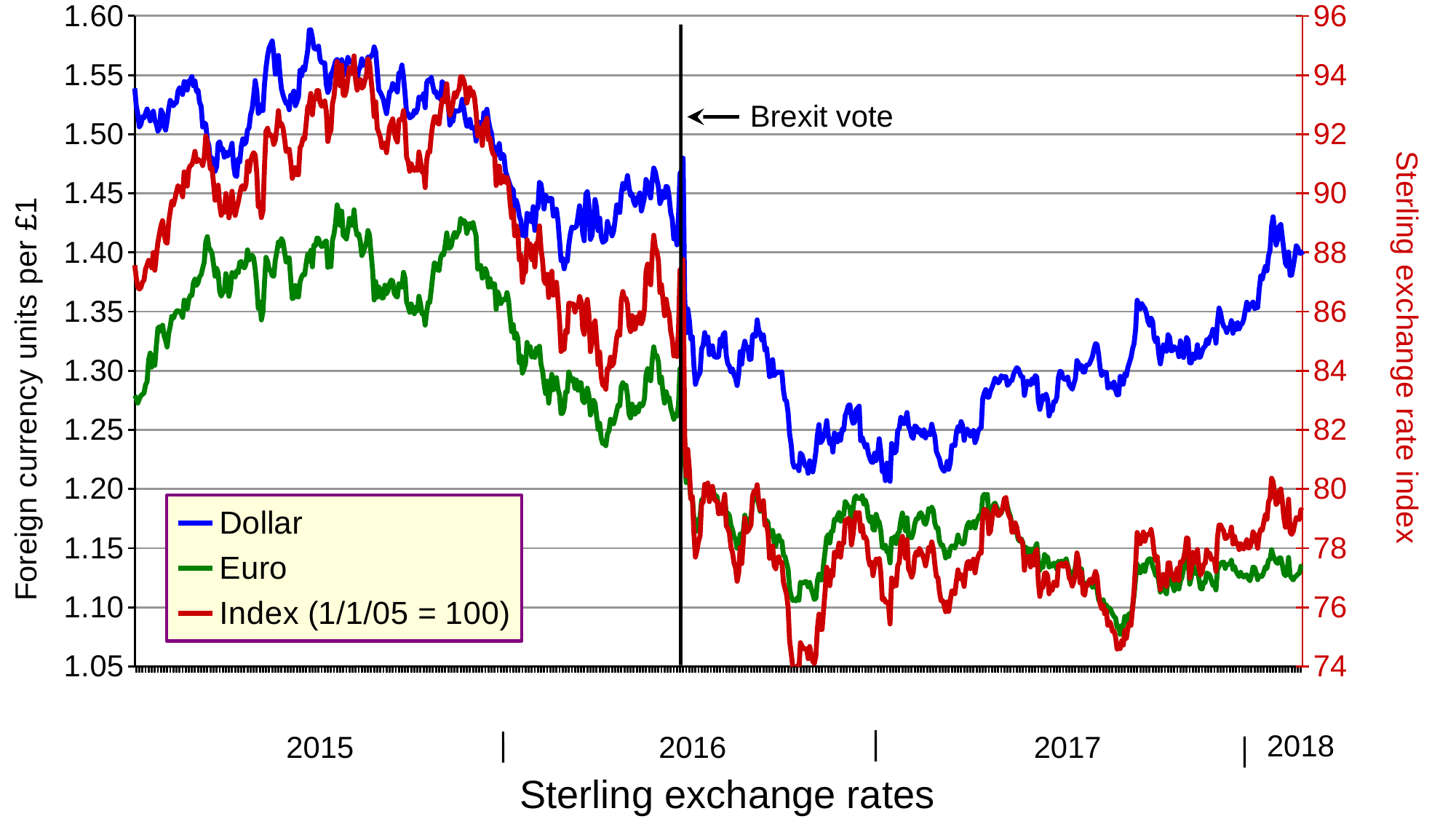
Is the Index value at the start of 2018 greater or less than 82? less Which line is higher throughout the chart, Dollar or Euro? Dollar Is the lowest point of the Dollar line greater or less than 1.25? less What kind of chart is shown on the slide? Line chart Is the Dollar value at the start of 2015 greater or less than 1.50? greater What is the title of the chart? Sterling exchange rates How many series does the legend list? 3 Does the Euro line rise or fall immediately after the Brexit vote? Fall What event does the vertical black line on the chart mark? Brexit vote Does the Dollar line overall rise or fall from the start of 2015 to the start of 2018? Fall